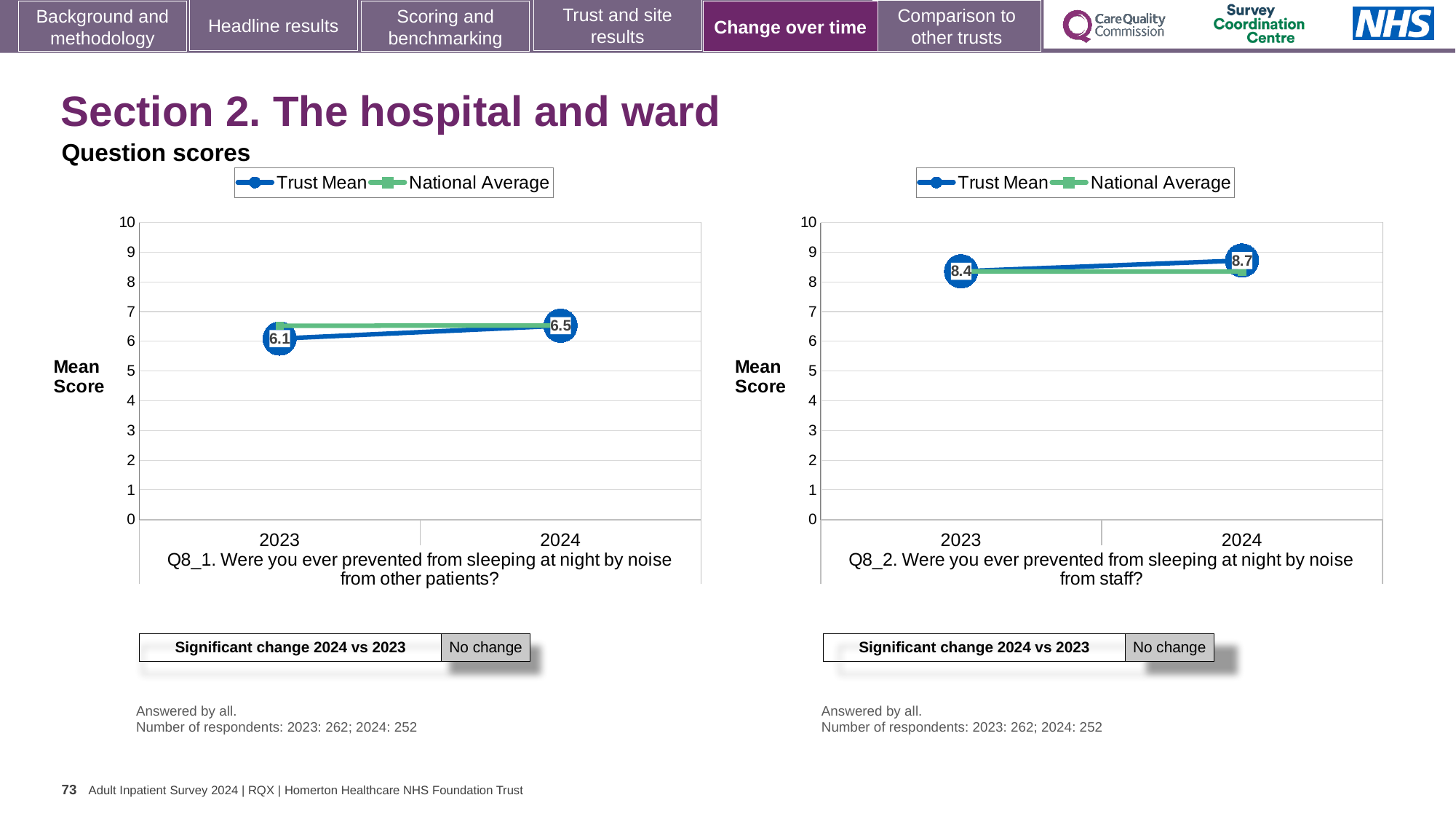
In the right chart (Q8_2), what is the Trust Mean score for 2023? 8.4 In the left chart (Q8_1), which year has the higher Trust Mean, 2023 or 2024? 2024 In the left chart (Q8_1), by how much did the Trust Mean change from 2023 to 2024? 0.4 In the right chart (Q8_2), is the National Average value for 2024 greater or less than 9? less What kind of chart is used for Q8_1 on the left? line chart In the left chart (Q8_1), is the National Average value for 2023 greater or less than 6? greater In the left chart (Q8_1), what is the Trust Mean score for 2024? 6.5 In the right chart (Q8_2), what is the Trust Mean score for 2024? 8.7 In the right chart (Q8_2), what is the difference between the Trust Mean for 2024 and 2023? 0.3 How many series does the legend of the right chart (Q8_2) list? 2 In the right chart (Q8_2), does the Trust Mean rise or fall from 2023 to 2024? rise In the left chart (Q8_1), what is the Trust Mean score for 2023? 6.1